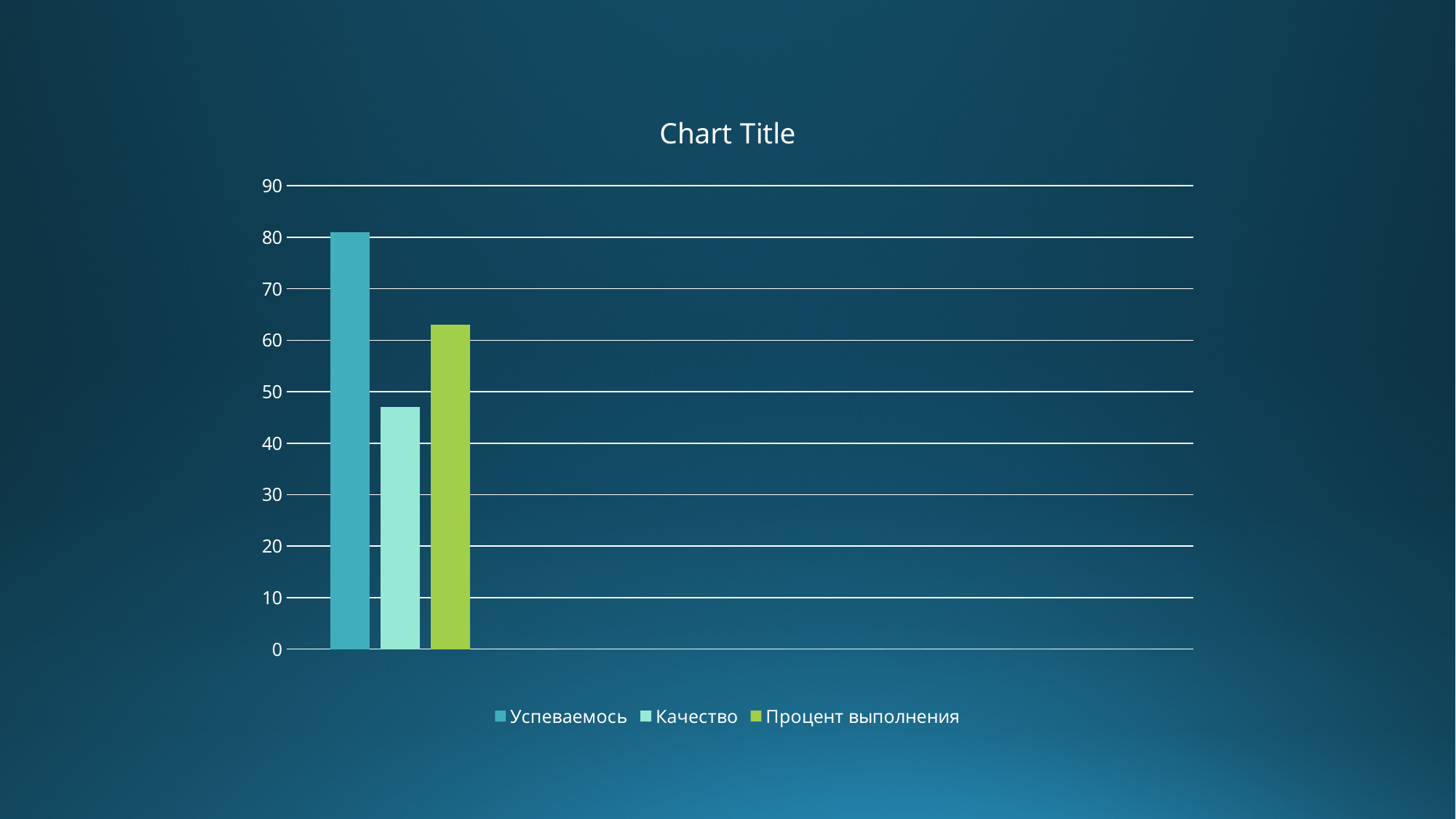
What kind of chart is shown on the slide? bar chart Is the value for Процент выполнения greater or less than 60? greater Which series has the lowest value? Качество Which series has the highest value? Успеваемось Which is larger, the value for Качество or the value for Процент выполнения? Процент выполнения Is the value for Успеваемость greater or less than 80? greater Which series is shown in green in the legend? Процент выполнения Is the value for Качество greater or less than 50? less Which is larger, the value for Успеваемость or the value for Процент выполнения? Успеваемось What is the title of the chart? Chart Title How many series does the legend list? 3